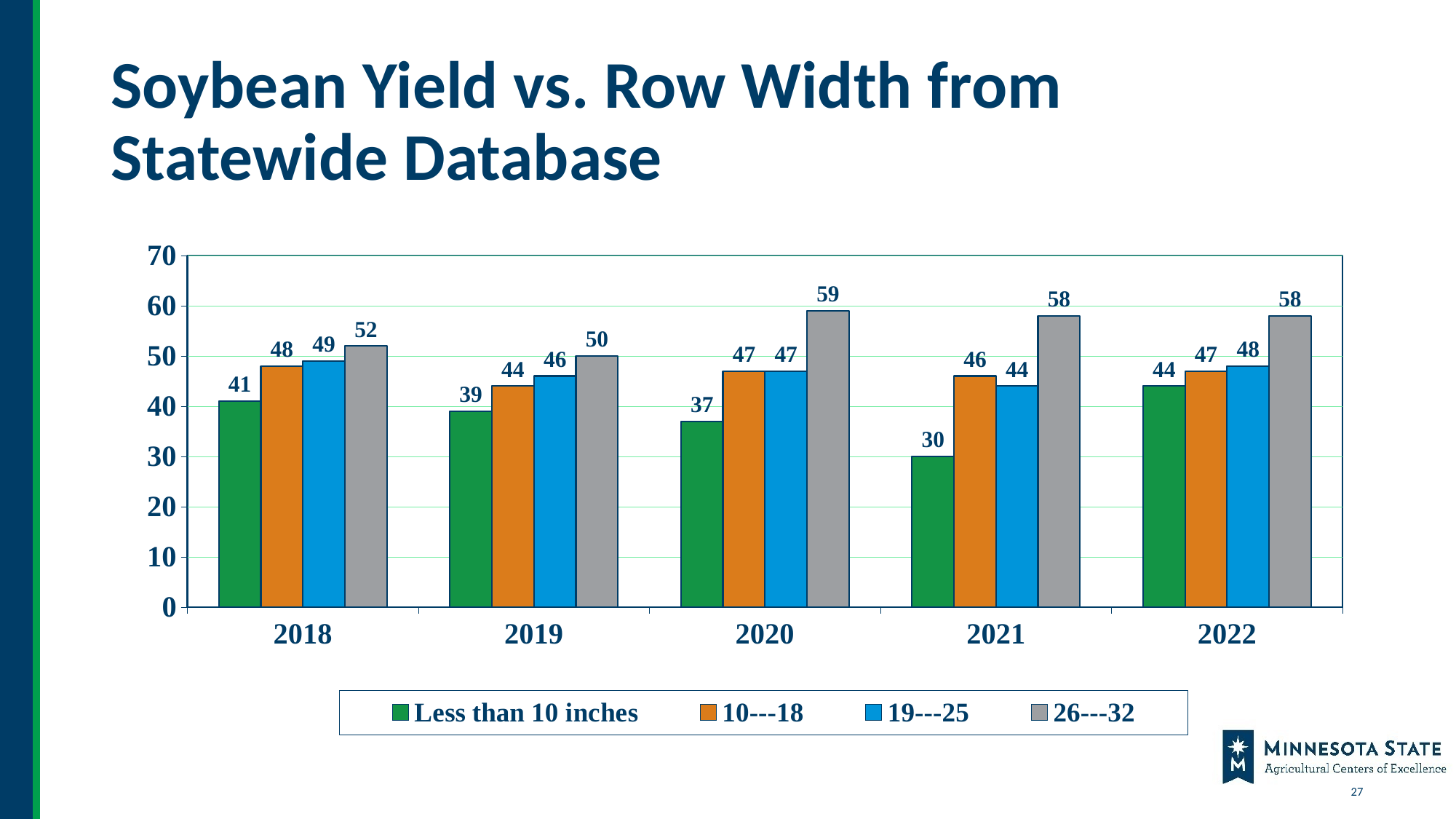
Which year has the highest value for the Less than 10 inches series? 2022 What is the value for the 26---32 series in 2020? 59 What is the value for the Less than 10 inches series in 2021? 30 What is the value for the 10---18 series in 2019? 44 How many series does the legend list? 4 What kind of chart is shown on the slide? Bar chart Which year has the lowest value for the 26---32 series? 2019 Which is larger in 2021: the 10---18 value or the 19---25 value? 10---18 What colour represents the 19---25 series in the legend? Blue Does the 26---32 series rise or fall from 2019 to 2020? Rise What is the difference between the 26---32 value and the Less than 10 inches value in 2021? 28 How many years are shown on the x axis? 5